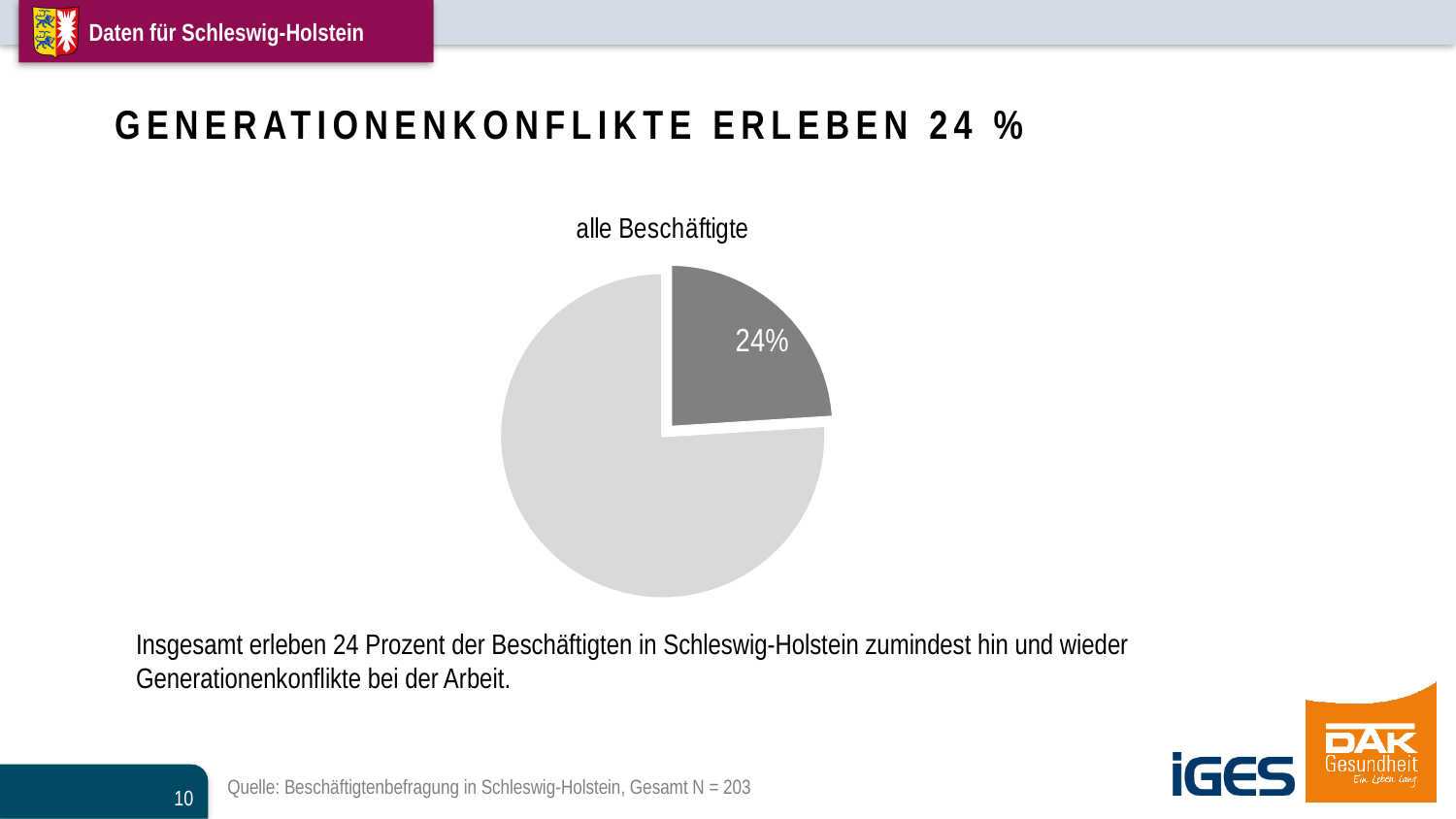
How many slices does the pie chart have? 2 What colour is the slice that carries the 24% label? dark grey What share of the pie does the labelled dark grey slice represent? 24% Which slice of the pie chart is larger, the dark grey slice or the light grey slice? the light grey slice What is the title shown above the pie chart? alle Beschäftigte What value is printed on the dark grey slice of the pie chart? 24% Which slice of the pie chart is the smallest? the dark grey 24% slice What kind of chart is shown on the slide? pie chart Is the dark grey slice of the pie chart greater or less than 50% of the pie? less